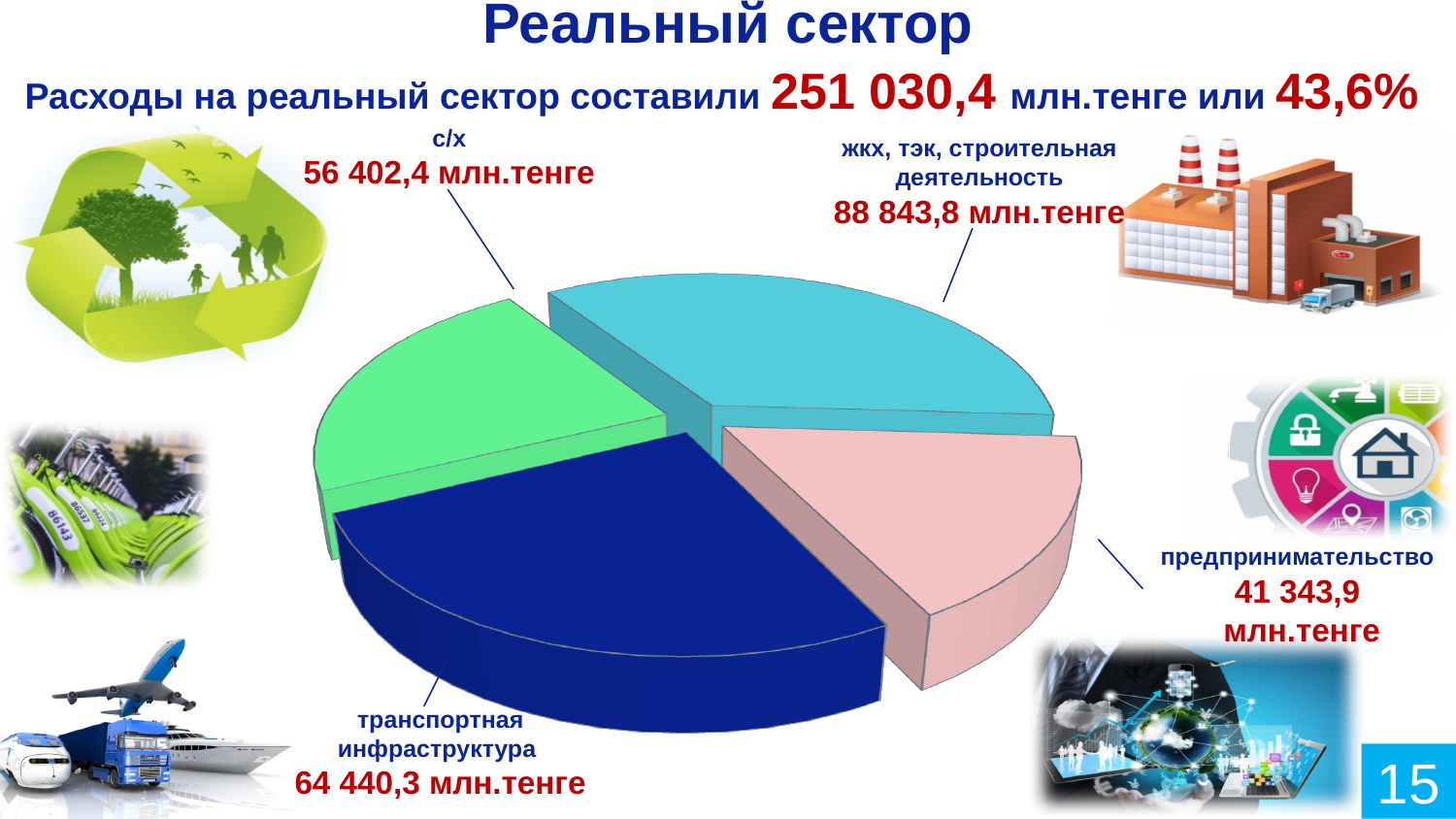
What is the value for транспортная инфраструктура? 64 440,3 млн.тенге What colour is the slice for транспортная инфраструктура? dark blue What is the total of all slices in the pie chart? 251 030,4 млн.тенге Which category has the largest slice of the pie chart? жкх, тэк, строительная деятельность What kind of chart is shown on the slide? pie chart How many slices does the pie chart have? 4 What is the value for жкх, тэк, строительная деятельность? 88 843,8 млн.тенге What is the value for с/х in the pie chart? 56 402,4 млн.тенге Which is larger, с/х or предпринимательство? с/х What is the difference between жкх, тэк, строительная деятельность and транспортная инфраструктура? 24 403,5 млн.тенге What is the value for предпринимательство? 41 343,9 млн.тенге Which category has the smallest slice of the pie chart? предпринимательство